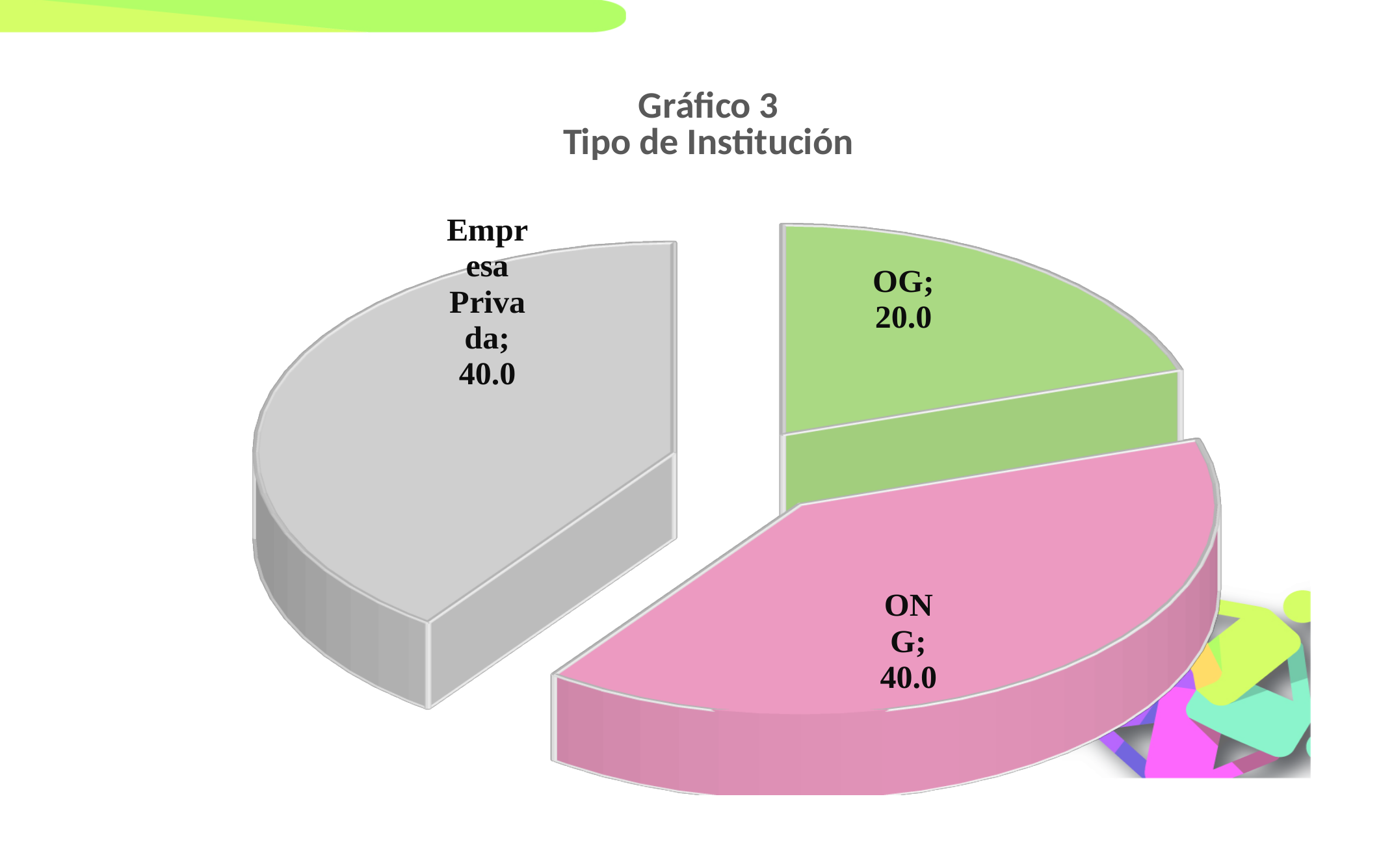
What value is shown for the Empresa Privada slice? 40.0 What value is shown for the OG slice? 20.0 What kind of chart is shown on the slide? Pie chart What is the title of the chart? Gráfico 3 Tipo de Institución How many categories are shown in the pie chart? 3 What share of the pie does the OG slice represent? 20% What is the difference between the ONG value and the OG value? 20.0 Which category has the smallest slice? OG What is the total of all the slice values? 100.0 Which is larger, the OG slice or the ONG slice? ONG What value is shown for the ONG slice? 40.0 What colour is the ONG slice? Pink